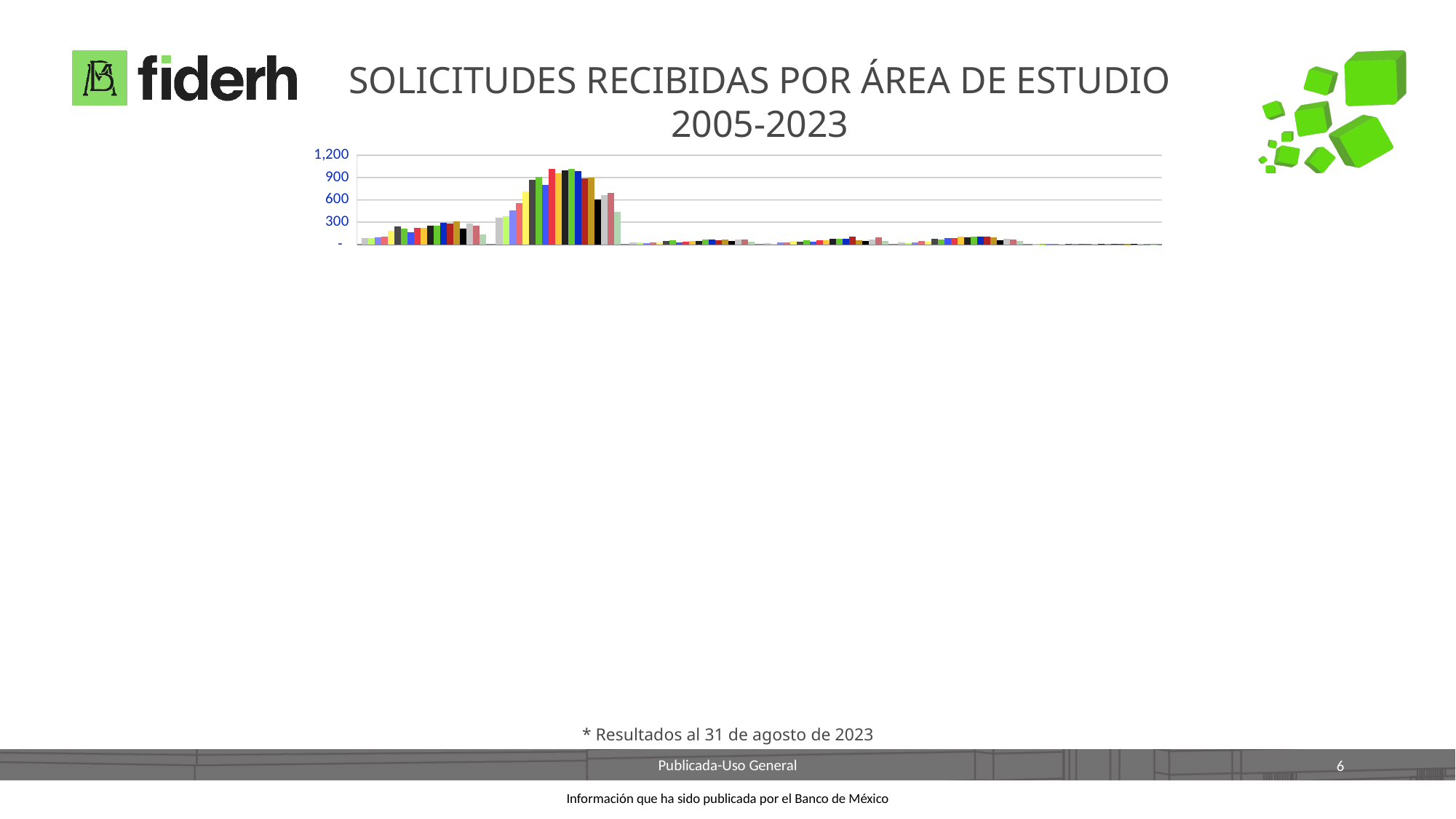
What is the highest tick value shown on the vertical axis of the chart? 1,200 Is the value of the tallest bar in the chart greater or less than 1,200? less Is the value of the tallest bar in the chart greater or less than 900? greater What kind of chart is shown on the slide? Bar chart What is the title of the chart on the slide? SOLICITUDES RECIBIDAS POR ÁREA DE ESTUDIO 2005-2023